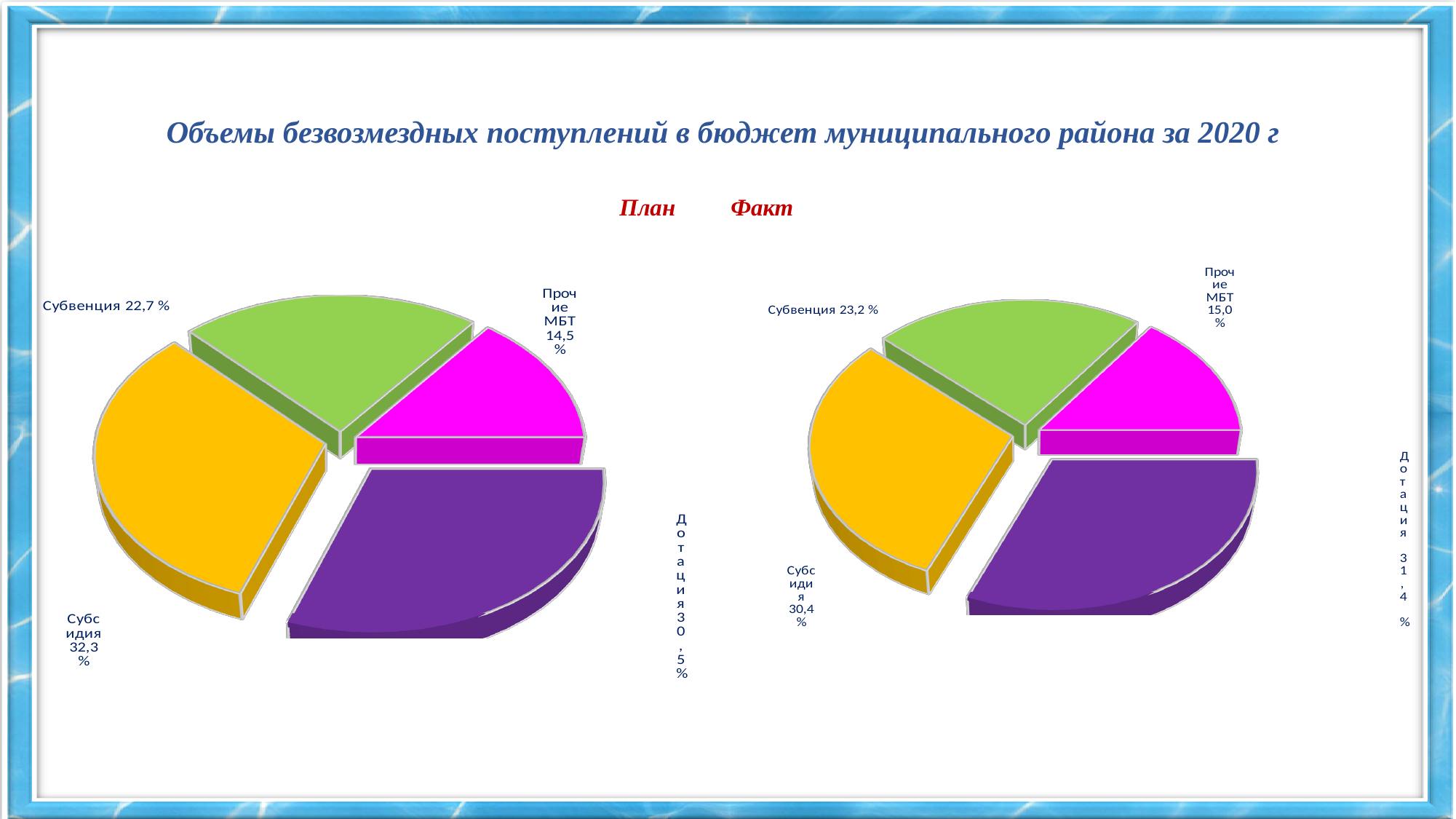
On the Факт pie chart, which category has the smallest share? Прочие МБТ On the Факт pie chart, what colour is the Дотация slice? Purple On the План pie chart, which category has the largest share? Субсидия On the План pie chart, what is the difference in percentage points between Субсидия and Дотация? 1,8 On the Факт pie chart, what is the share for Дотация? 31,4 % What kind of chart is used on the Факт side of the slide? Pie chart On the Факт pie chart, what is the share for Субсидия? 30,4 % On the План pie chart, what is the share for Субвенция? 22,7 % How many slices does the План pie chart have? 4 Which is larger: Субвенция on the План chart or Субвенция on the Факт chart? Факт On the Факт pie chart, which category has the largest share? Дотация On the План pie chart, what is the share for Прочие МБТ? 14,5 %